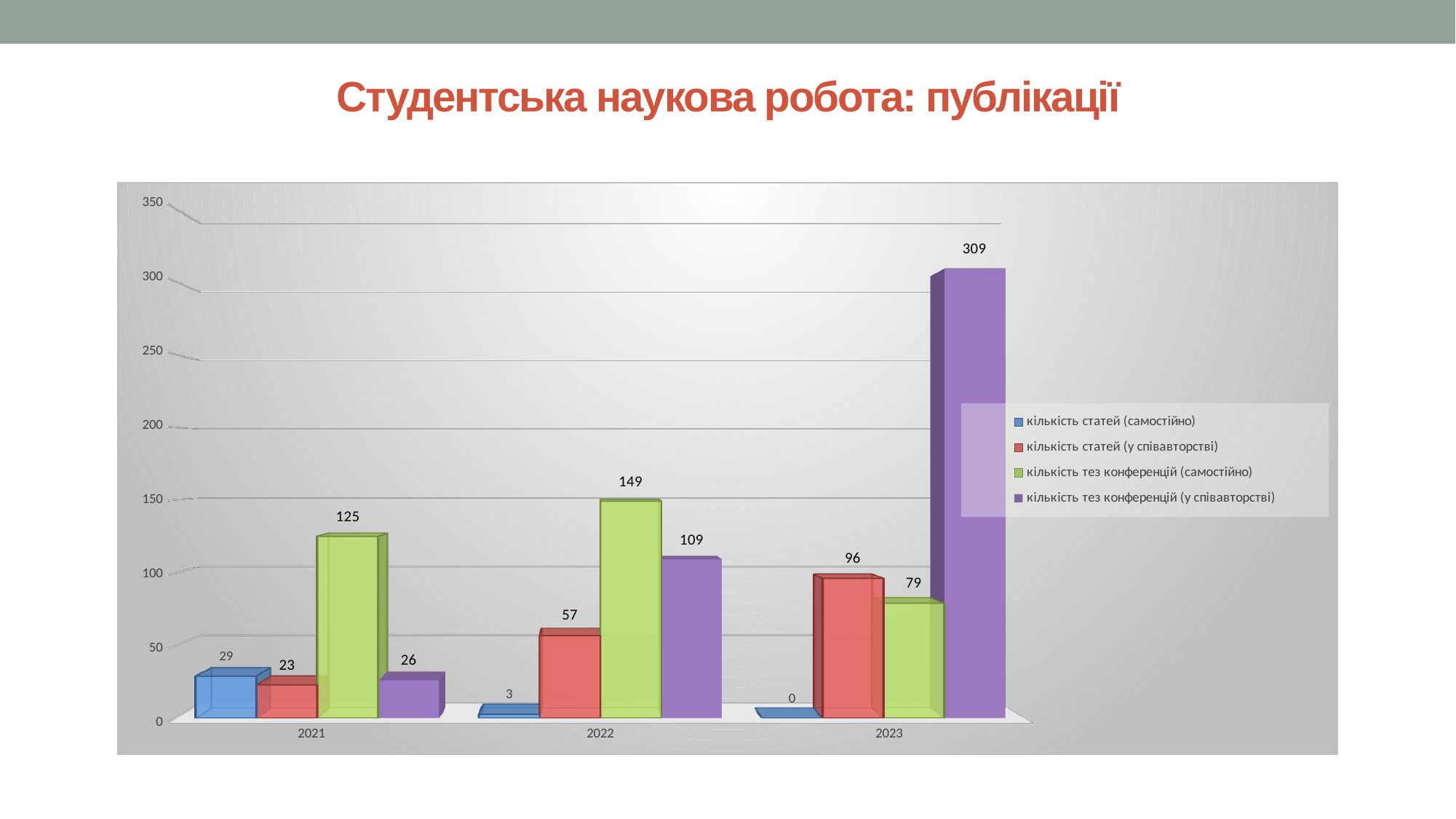
How many years are shown on the x axis? 3 What is the value for кількість статей (у співавторстві) in 2022? 57 In which year is кількість тез конференцій (самостійно) highest? 2022 What is the value for кількість статей (самостійно) in 2021? 29 What kind of chart is shown on the slide? bar chart What is the value for кількість тез конференцій (у співавторстві) in 2023? 309 In which year is кількість статей (самостійно) lowest? 2023 How many series does the legend list? 4 Does кількість статей (у співавторстві) rise or fall from 2021 to 2023? rise Which is larger in 2021: кількість тез конференцій (самостійно) or кількість тез конференцій (у співавторстві)? кількість тез конференцій (самостійно) What is the difference between кількість тез конференцій (у співавторстві) in 2023 and in 2022? 200 What is the value for кількість тез конференцій (самостійно) in 2023? 79